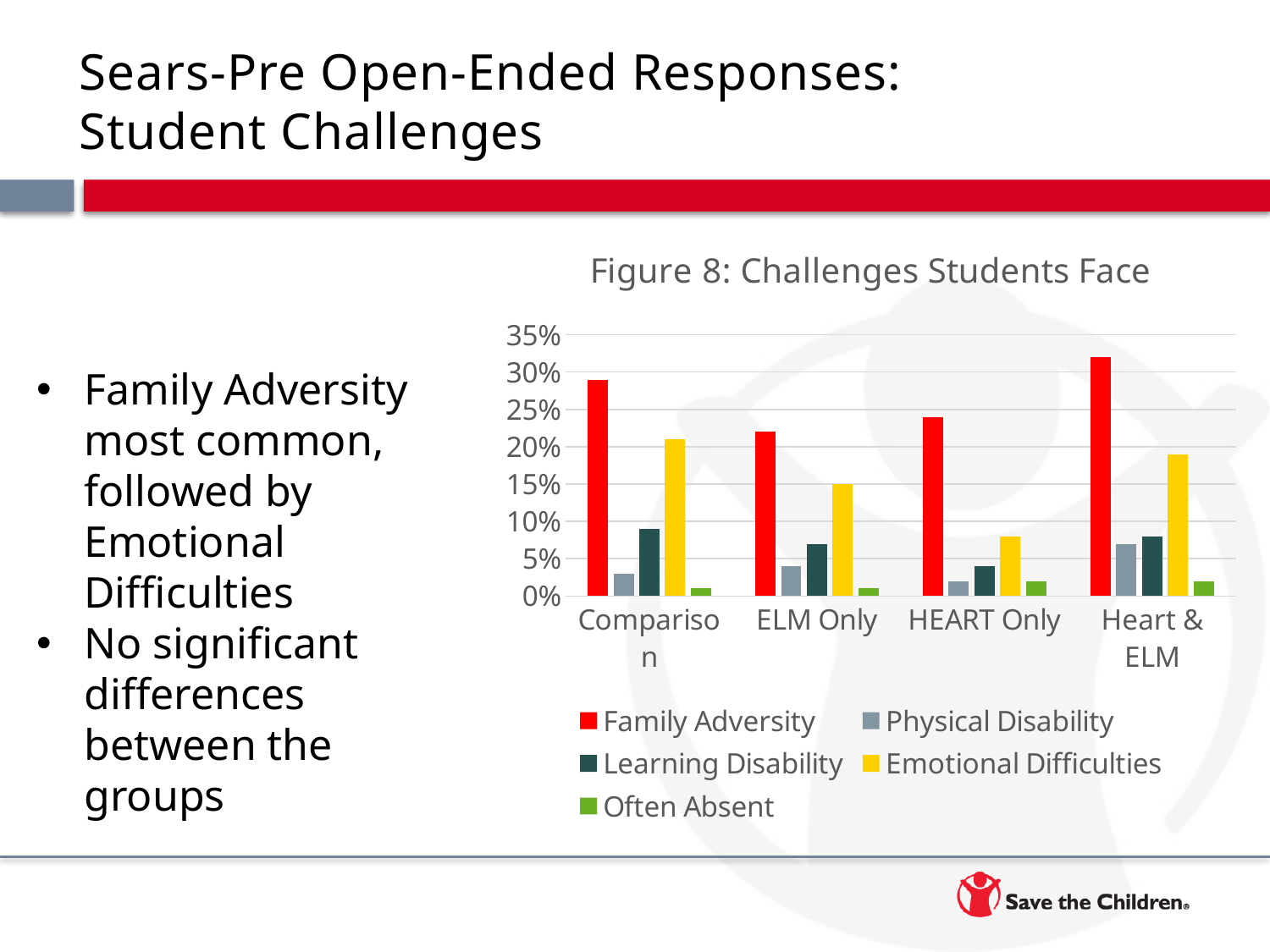
Is the Family Adversity value for Comparison greater or less than 25%? greater In the Comparison group, which is larger: Learning Disability or Physical Disability? Learning Disability How many groups are shown along the x axis of the chart? 4 Is the Family Adversity value for Heart & ELM greater or less than 25%? greater What kind of chart is shown in Figure 8: Challenges Students Face? bar chart Is the Emotional Difficulties value for HEART Only greater or less than 10%? less Which group has the lowest Emotional Difficulties value? HEART Only Which group has the highest Family Adversity value? Heart & ELM Which is larger: the Emotional Difficulties value for Comparison or for ELM Only? Comparison What is the title of the chart on the slide? Figure 8: Challenges Students Face How many series does the legend of the chart list? 5 What colour represents Family Adversity in the chart? red